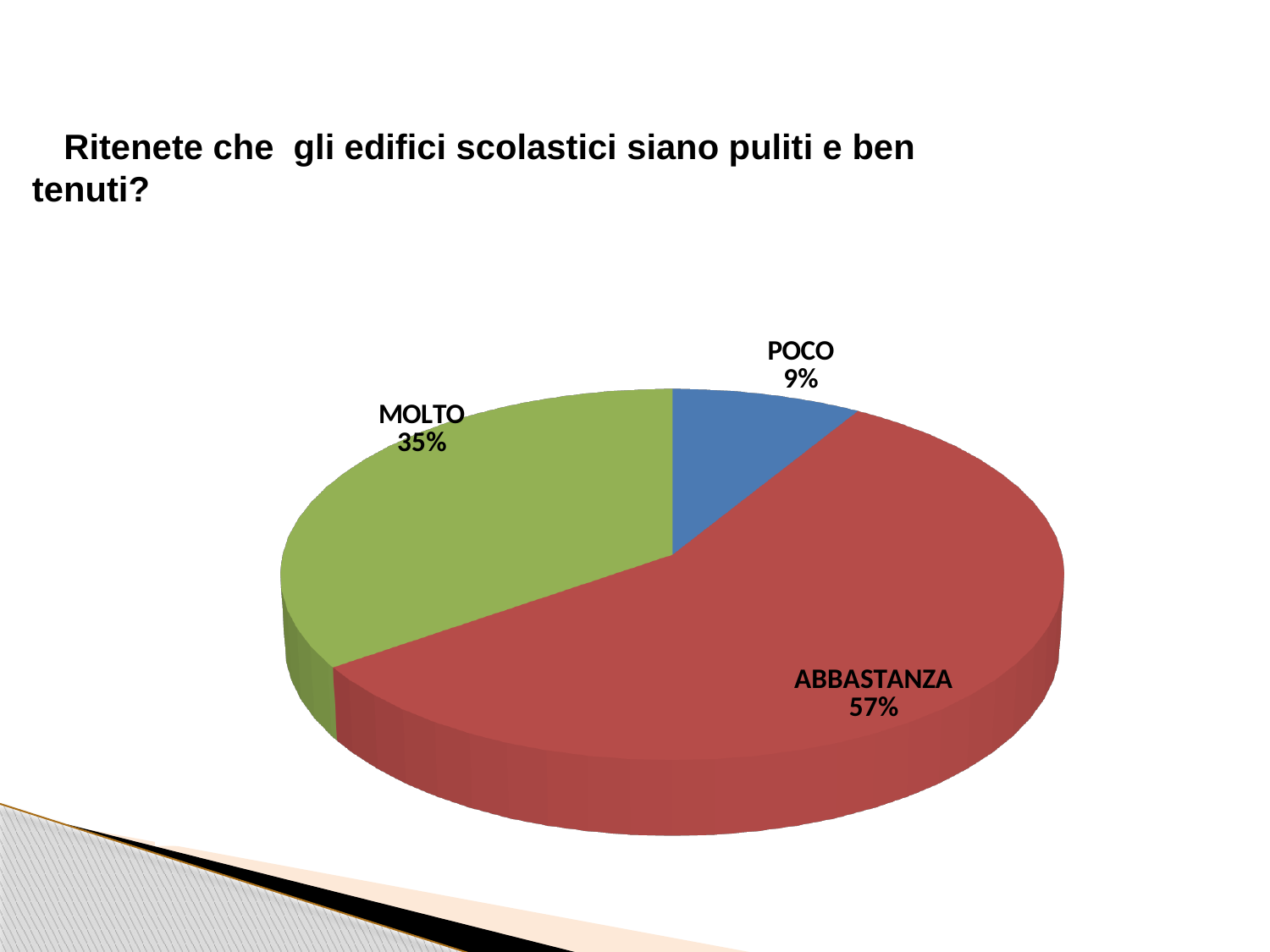
What is the difference in percentage points between MOLTO and POCO? 26 What question does the chart on the slide answer? Ritenete che gli edifici scolastici siano puliti e ben tenuti? What type of chart is shown on the slide? pie chart What colour is the ABBASTANZA slice? red What percentage of respondents answered MOLTO? 35% What percentage of respondents answered POCO? 9% What percentage of respondents answered ABBASTANZA? 57% Which response has the largest share of the pie? ABBASTANZA How many slices does the pie chart have? 3 Which is larger, the share for MOLTO or the share for POCO? MOLTO What is the difference in percentage points between ABBASTANZA and MOLTO? 22 Which response has the smallest share of the pie? POCO